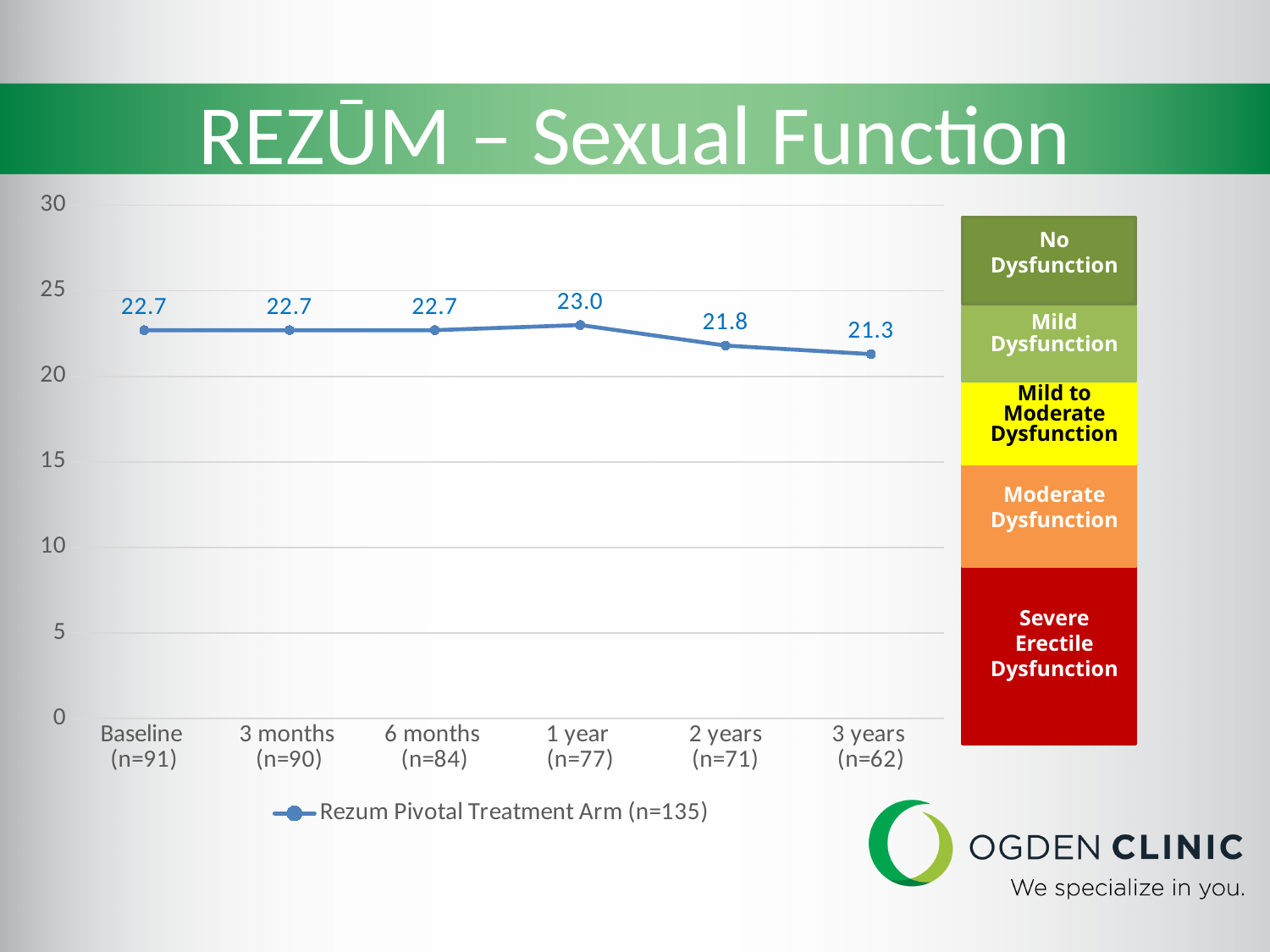
How many time points are plotted on the x axis? 6 What is the value at Baseline (n=91)? 22.7 Which is larger, the value at 2 years or the value at 3 years? 2 years What is the value at 1 year (n=77)? 23.0 What is the value at 3 years (n=62)? 21.3 What is the difference between the value at 1 year and the value at 3 years? 1.7 At which time point is the value lowest? 3 years (n=62) Is the value at 6 months greater or less than 20? greater What is the value at 2 years (n=71)? 21.8 What is the name of the series shown in the legend? Rezum Pivotal Treatment Arm (n=135) At which time point is the value highest? 1 year (n=77) What kind of chart is shown? line chart